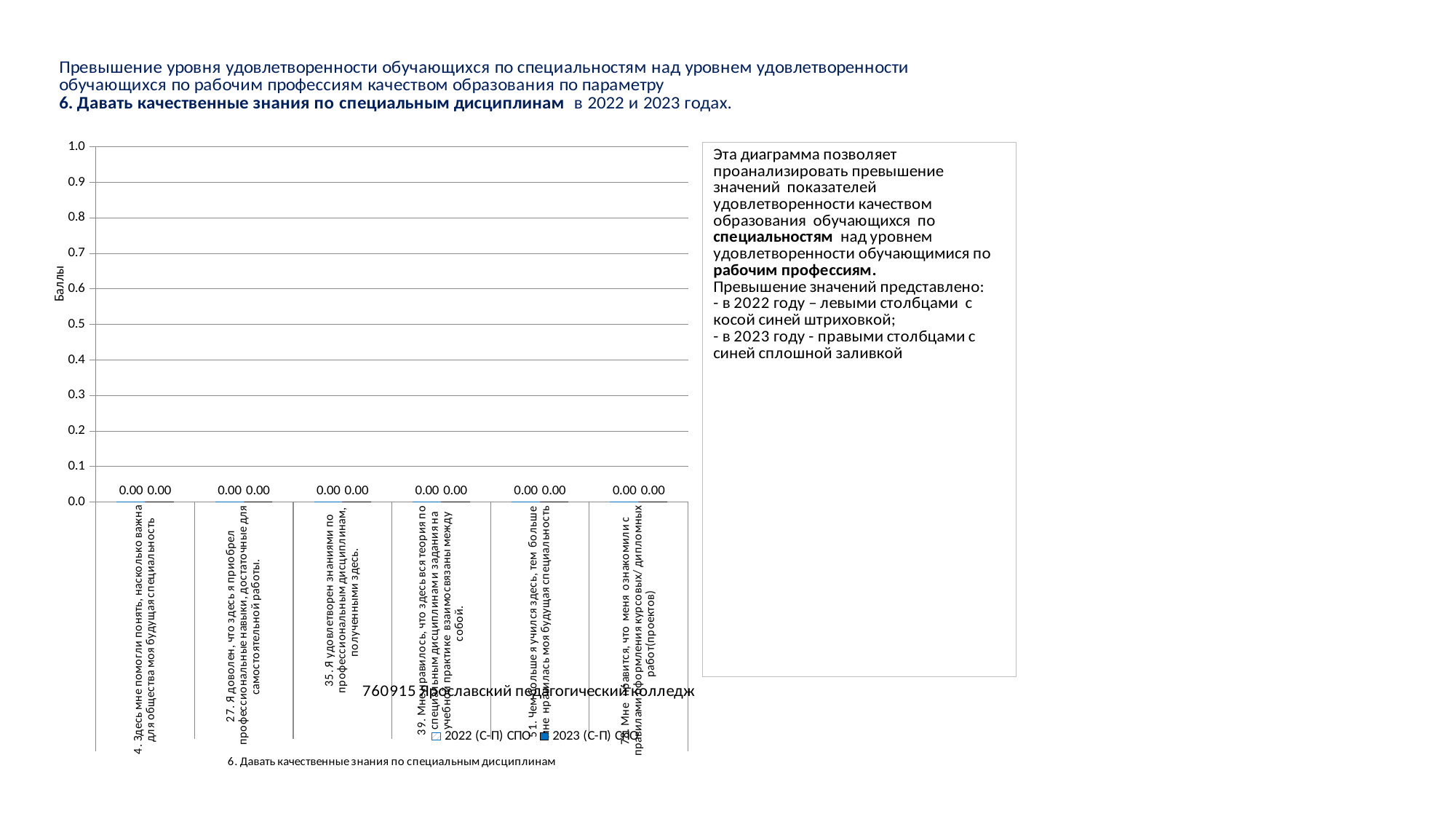
What is the value for the 2023 (С-П) СПО series for category 27 ("Я доволен, что здесь я приобрел профессиональные навыки, достаточные для самостоятельной работы")? 0.00 How many series does the chart legend list? 2 What is the difference between the 2022 (С-П) СПО and 2023 (С-П) СПО values for category 39? 0.00 What is the title of the vertical axis of the chart? Баллы What is the value for the 2023 (С-П) СПО series for category 51 ("Чем больше я учился здесь, тем больше мне нравилась моя будущая специальность")? 0.00 What is the maximum value shown on the vertical axis of the chart? 1.0 How many categories are shown on the x axis of the chart? 6 What kind of chart is shown on the slide? Bar chart Is the value for the 2022 (С-П) СПО series for category 4 greater or less than 0.1? less What is the value for the 2022 (С-П) СПО series for category 4 ("Здесь мне помогли понять, насколько важна для общества моя будущая специальность")? 0.00 What is the value for the 2022 (С-П) СПО series for category 35 ("Я удовлетворен знаниями по профессиональным дисциплинам, полученными здесь")? 0.00